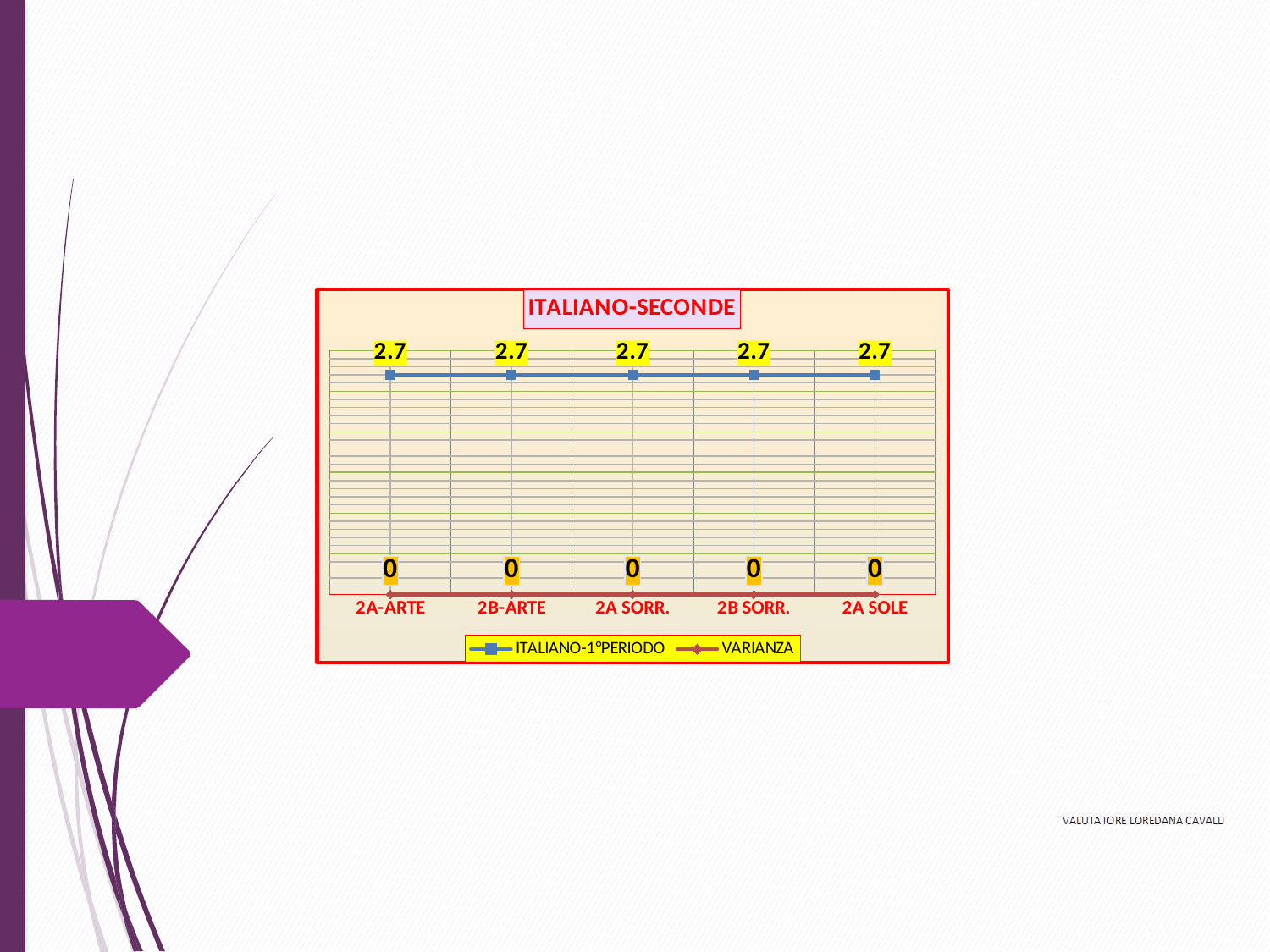
What is the title of the chart? ITALIANO-SECONDE Which series has the larger value for 2B-ARTE, ITALIANO-1°PERIODO or VARIANZA? ITALIANO-1°PERIODO Which series is drawn with the blue line? ITALIANO-1°PERIODO What kind of chart is shown on the slide? line chart How many categories are shown on the x axis? 5 What is the VARIANZA value for 2B SORR.? 0 What is the difference between the ITALIANO-1°PERIODO value and the VARIANZA value for 2A SORR.? 2.7 What is the VARIANZA value for 2B-ARTE? 0 What is the ITALIANO-1°PERIODO value for 2A-ARTE? 2.7 How many series does the legend list? 2 Does the ITALIANO-1°PERIODO series rise, fall or stay flat across the categories? stays flat What is the ITALIANO-1°PERIODO value for 2A SOLE? 2.7